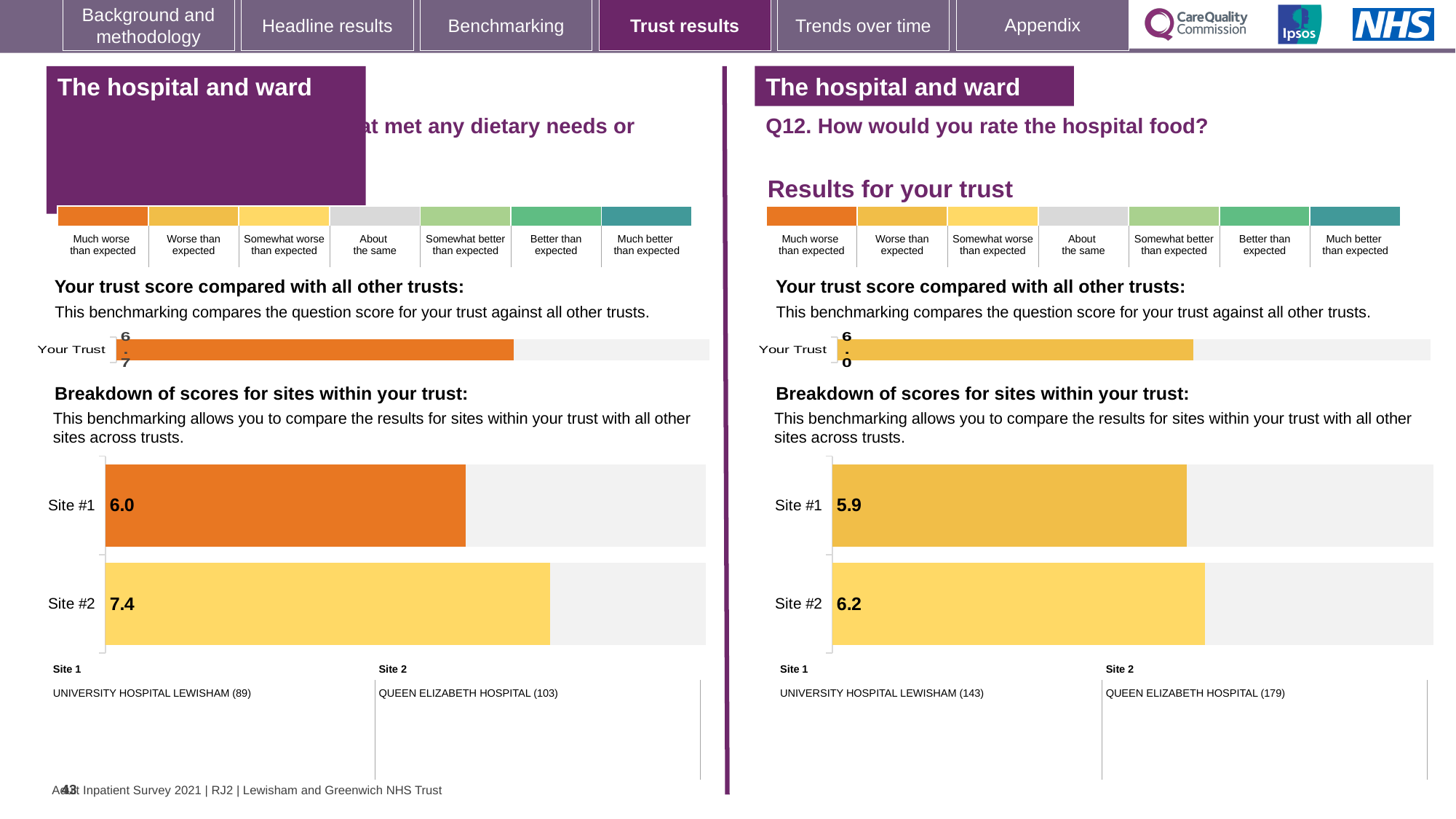
What type of chart is used for the site breakdown on the right-hand side (Q12)? Bar chart On the right-hand chart (Q12. How would you rate the hospital food?), what is the score for Site #2? 6.2 On the left-hand site breakdown chart, which site has the higher score? Site #2 On the right-hand chart (Q12. How would you rate the hospital food?), what is the score for Site #1? 5.9 On the right-hand site breakdown chart (Q12), which site has the lower score? Site #1 On the right-hand site breakdown chart (Q12), what is the difference between the Site #2 and Site #1 scores? 0.3 How many sites are shown in the right-hand site breakdown chart (Q12)? 2 On the right-hand chart (Q12. How would you rate the hospital food?), what is the score shown for Your Trust? 6.0 On the left-hand site breakdown chart, what is the difference between the Site #2 and Site #1 scores? 1.4 On the left-hand chart, what is the score shown for Your Trust? 6.7 On the left-hand chart, what is the score for Site #2? 7.4 On the left-hand chart, what is the score for Site #1? 6.0